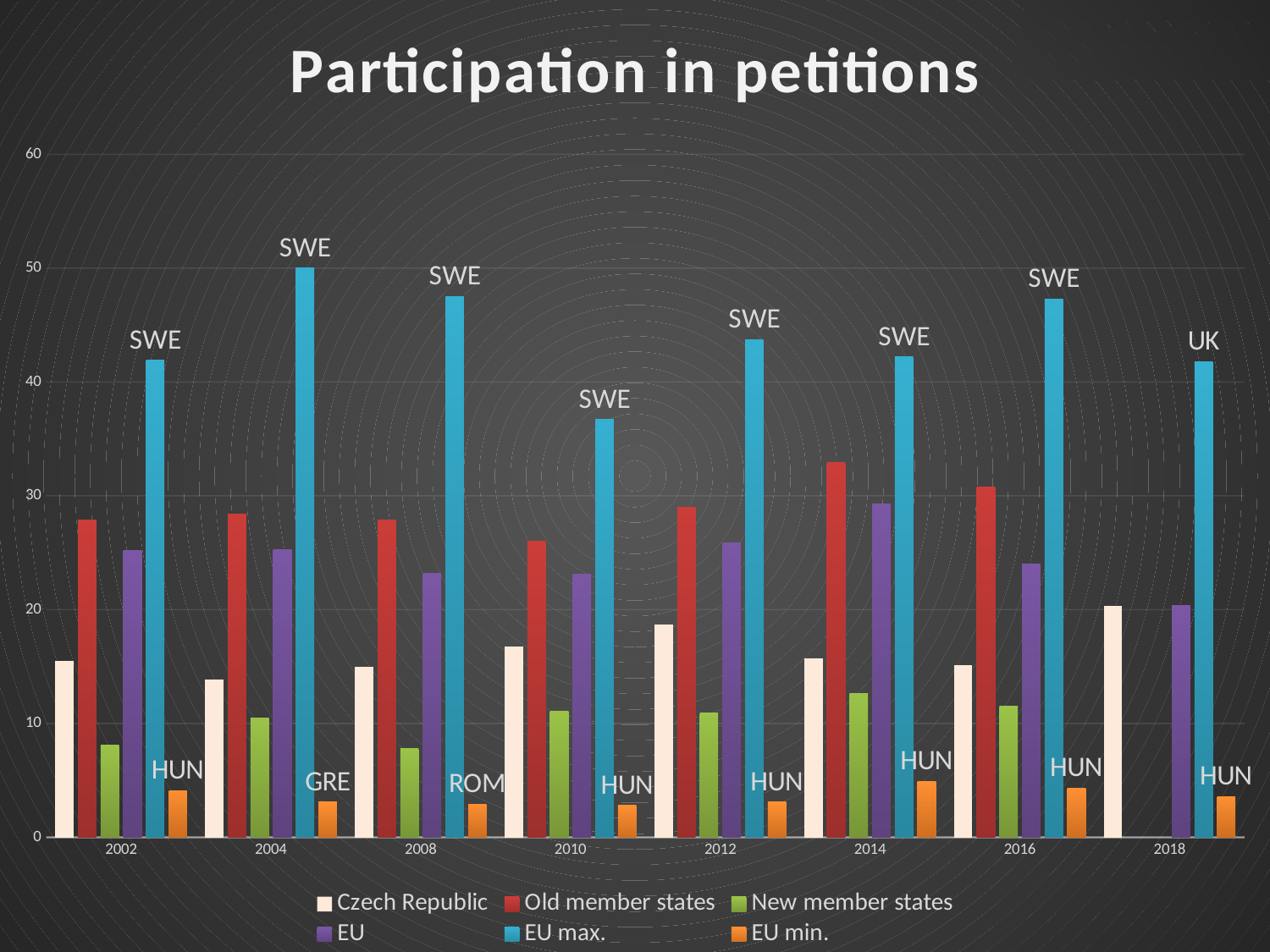
Which year has the lowest EU max. value? 2010 What kind of chart is shown on the slide? bar chart How many series does the legend list? 6 Which year has the highest value for Old member states? 2014 Which year has the highest value for Czech Republic? 2018 How many years are shown on the x axis? 8 Is the Czech Republic value for 2012 greater or less than 20? less Which country label is shown on the EU max. bar for 2018? UK In 2010, which is larger: the Czech Republic value or the New member states value? Czech Republic Is the Old member states value for 2014 greater or less than 30? greater Which year has the highest EU max. value? 2004 Is the EU max. value for 2002 greater or less than 40? greater